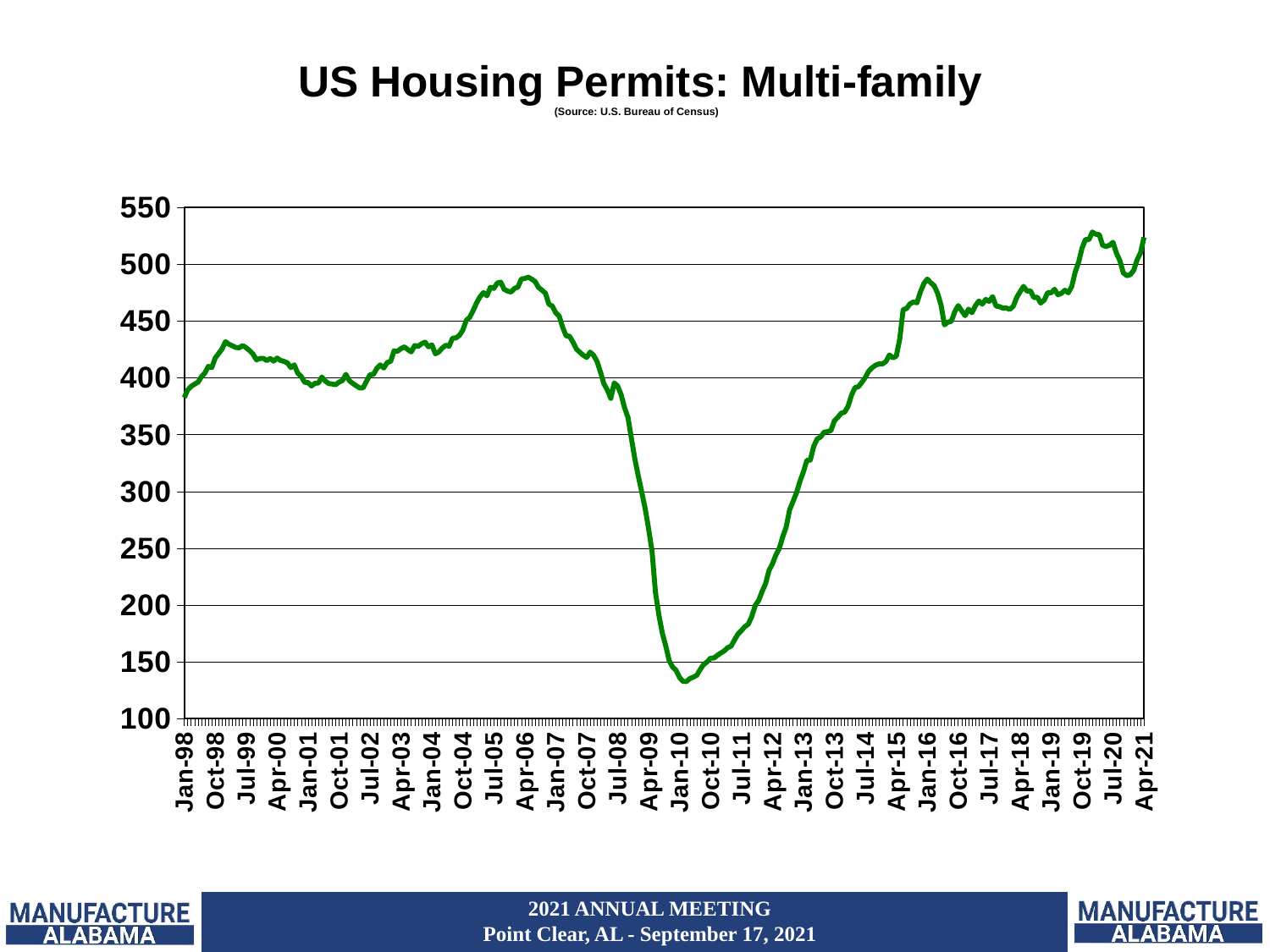
Is the value for Jan-10 greater or less than 150? less Does the line rise or fall between Jan-10 and Jan-16? rise Does the line rise or fall between Apr-06 and Jan-10? fall What kind of chart is shown on the slide? line chart What is the title of the chart? US Housing Permits: Multi-family Is the value for Jul-11 greater or less than 200? less Is the value for Apr-06 greater or less than 450? greater Around which x-axis label does the line reach its lowest point? Jan-10 What source is cited for the chart data? U.S. Bureau of Census